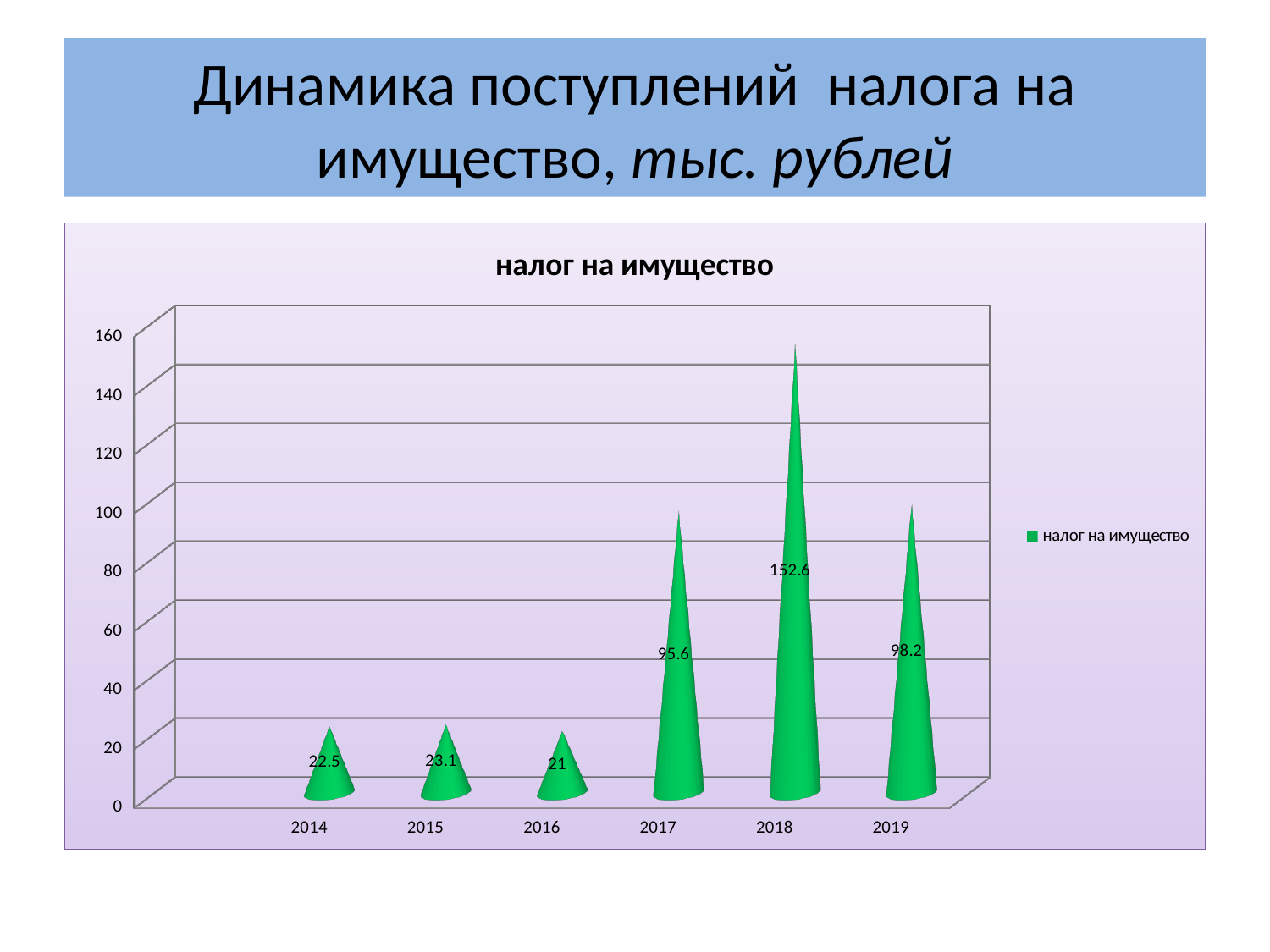
What is the value for 2018 in the chart? 152.6 How many series does the legend list? 1 What is the value for 2016 in the chart? 21 What is the title of the chart? налог на имущество Which year has the highest value in the chart? 2018 What is the difference between the values for 2018 and 2017? 57 How many years are shown on the x axis of the chart? 6 Which year has the lowest value in the chart? 2016 Is the value for 2018 greater or less than 140? greater What is the difference between the values for 2019 and 2017? 2.6 Which is larger, the value for 2019 or the value for 2017? 2019 What is the value for 2014 in the chart? 22.5